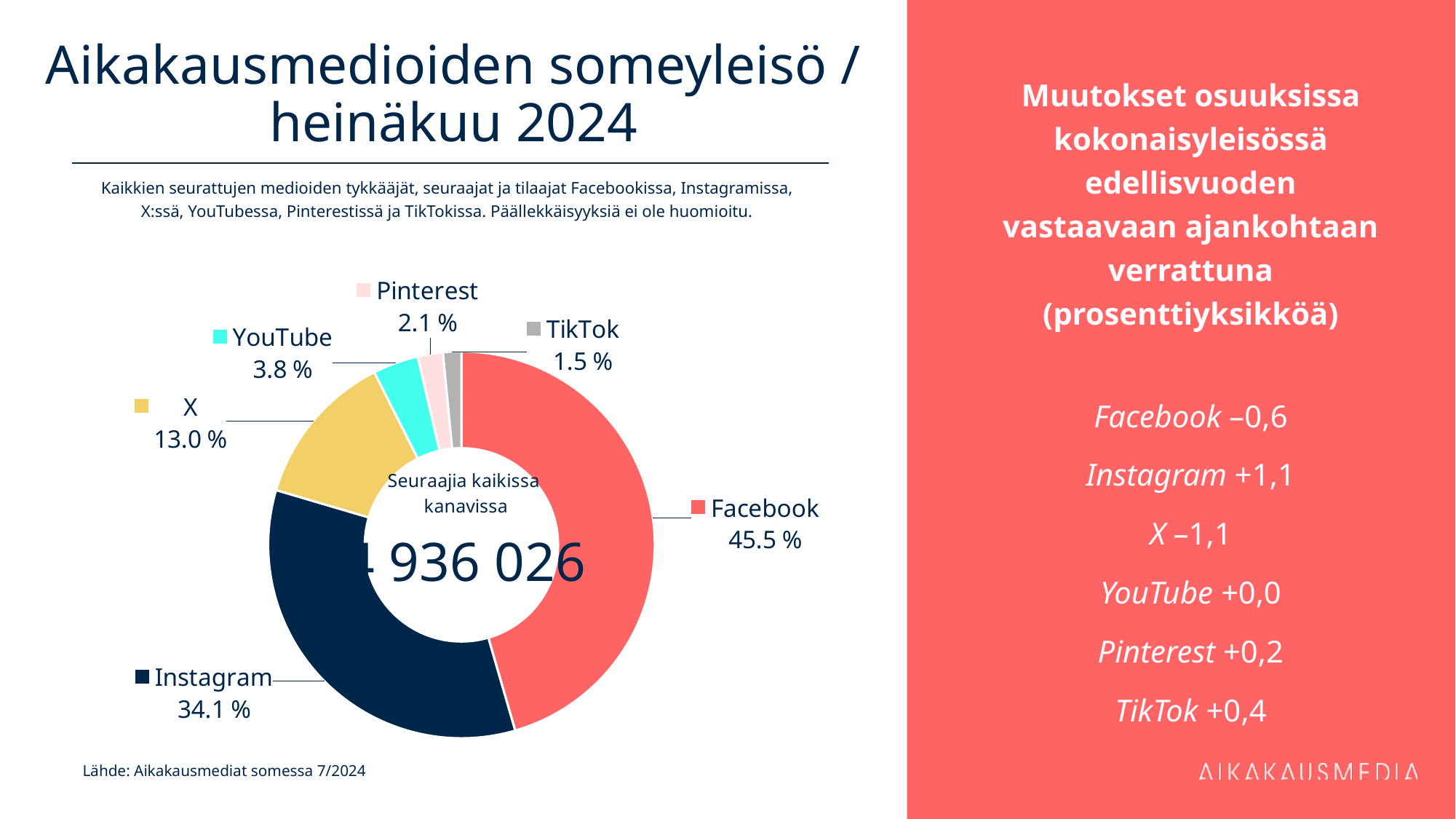
What share of the social media audience does Facebook hold? 45.5 % What share of the social media audience does X hold? 13.0 % What is the combined share of YouTube, Pinterest and TikTok? 7.4 % What is the difference in percentage points between Facebook's share and Instagram's share? 11.4 Which channel has the smallest share of the audience? TikTok Which has a larger share, YouTube or Pinterest? YouTube What colour is the Instagram slice in the chart? Dark navy blue How many channels are shown in the chart? 6 What share of the social media audience does Instagram hold? 34.1 % What share of the social media audience does TikTok hold? 1.5 % Which channel has the largest share of the audience? Facebook What kind of chart is shown on the slide? Pie chart (donut)